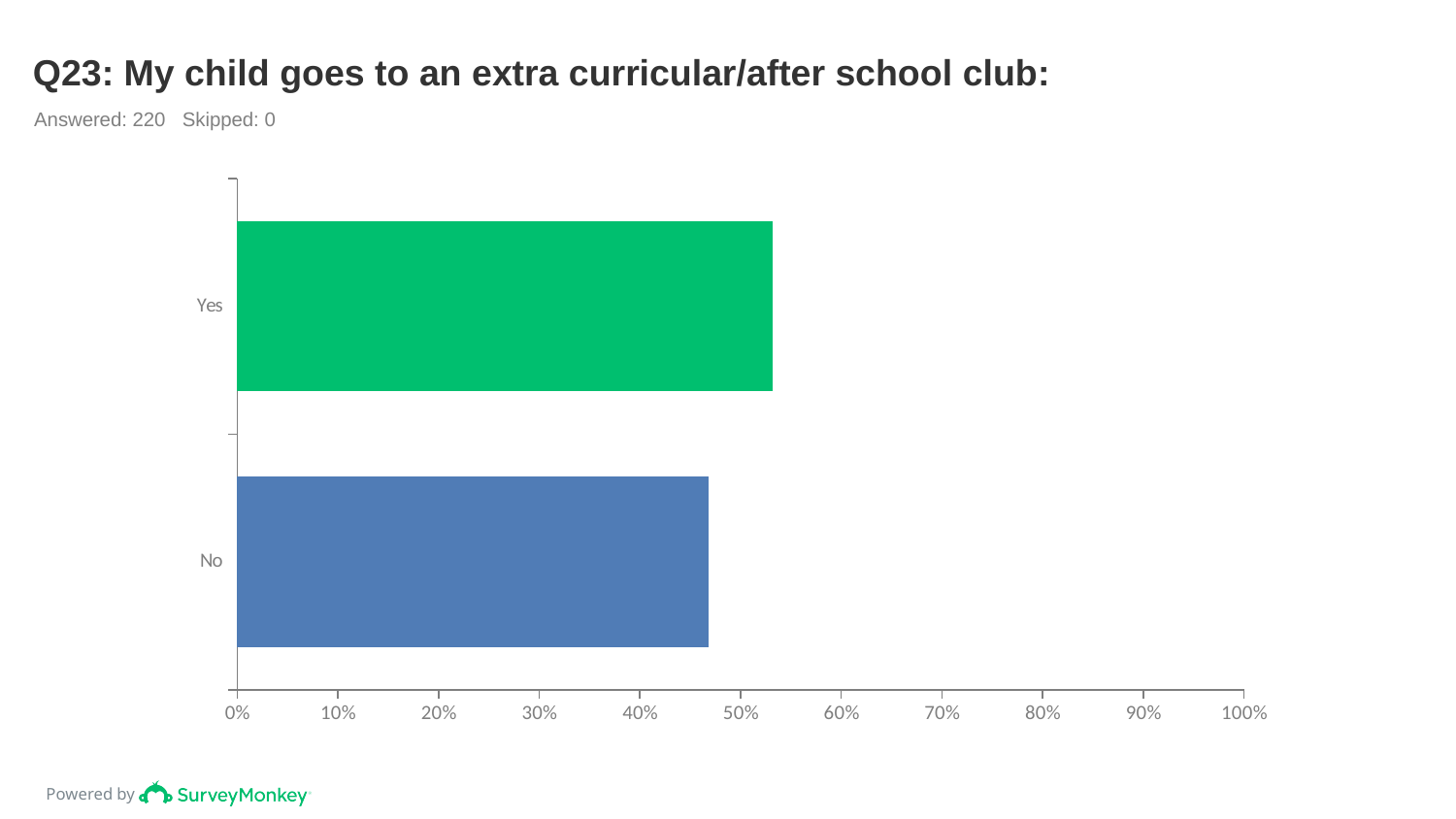
What is the title of the chart? Q23: My child goes to an extra curricular/after school club: Which category has the highest value? Yes Which category has the lowest value? No Is the value for No greater or less than 40%? greater What kind of chart is shown on the slide? bar chart Which is larger, the value for Yes or the value for No? Yes Is the value for No greater or less than 50%? less Is the value for Yes greater or less than 60%? less What colour is the bar for Yes? green How many categories are plotted in the chart? 2